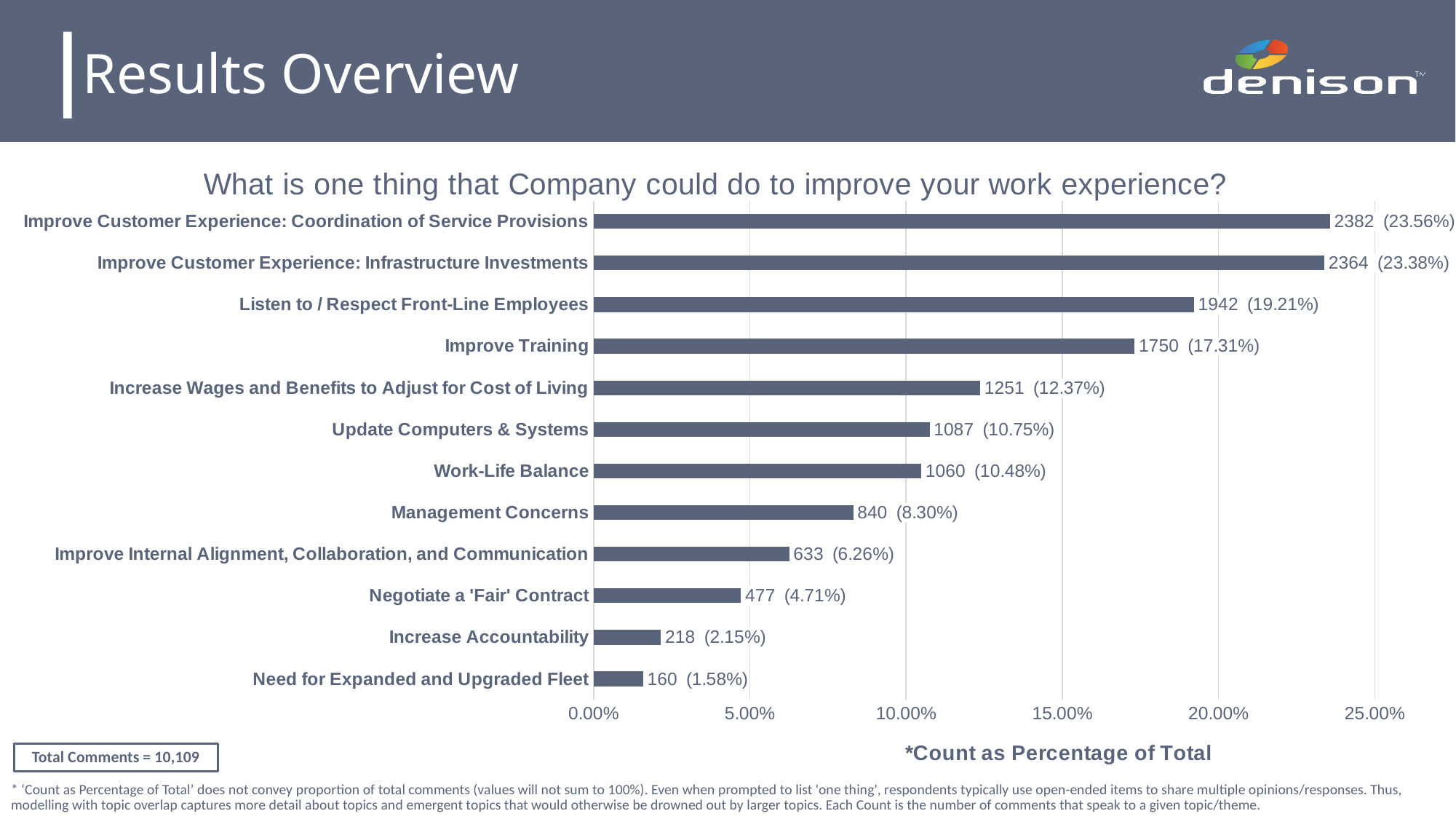
Which category has the lowest count? Need for Expanded and Upgraded Fleet What is the count for Negotiate a 'Fair' Contract? 477 Which category has the highest count? Improve Customer Experience: Coordination of Service Provisions What is the title of the chart? What is one thing that Company could do to improve your work experience? What is the difference in count between Update Computers & Systems and Work-Life Balance? 27 Which has a higher count, Management Concerns or Increase Accountability? Management Concerns What is the total number of comments stated on the slide? 10,109 What percentage is shown for Work-Life Balance? 10.48% What kind of chart is shown on the slide? Bar chart Is the value for Increase Wages and Benefits to Adjust for Cost of Living greater or less than 10.00%? greater How many categories are shown in the chart? 12 What is the count for Improve Training? 1750